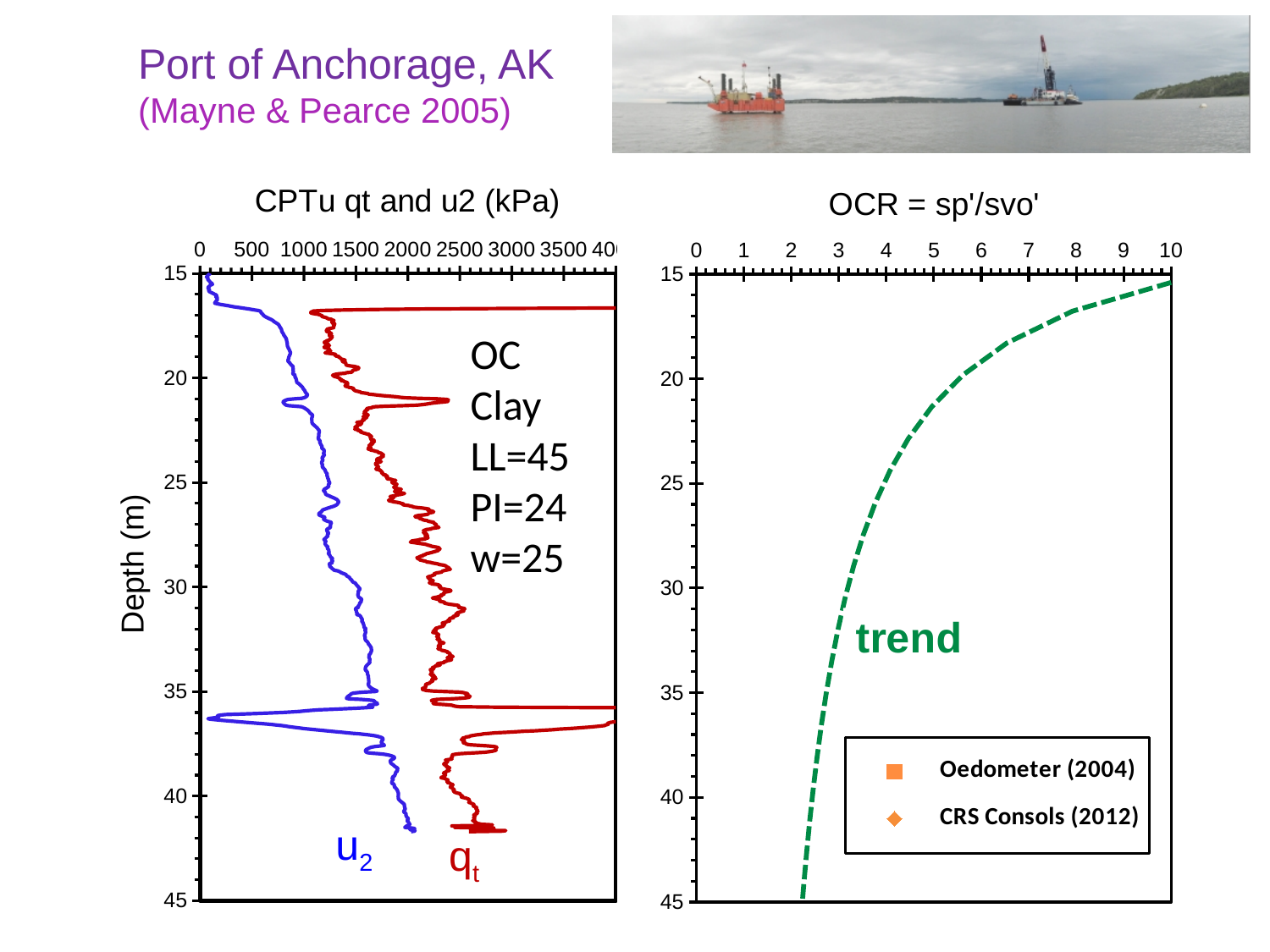
In the right chart "OCR = sp'/svo'", how many entries does the legend list? 2 In the left chart "CPTu qt and u2 (kPa)", at a depth of 30 m, which series has the larger value, qt or u2? qt In the left chart "CPTu qt and u2 (kPa)", what is the label of the vertical axis? Depth (m) In the left chart "CPTu qt and u2 (kPa)", does the u2 series generally increase or decrease as depth increases from 15 m to 40 m? increase What kind of chart is the right chart titled "OCR = sp'/svo'"? line chart In the right chart "OCR = sp'/svo'", at a depth of 40 m, is the trend line's OCR value greater or less than 3? less In the left chart "CPTu qt and u2 (kPa)", at a depth of 25 m, is the u2 value greater or less than 1500? less In the right chart "OCR = sp'/svo'", does the trend line's OCR value increase or decrease as depth increases? decrease In the left chart "CPTu qt and u2 (kPa)", how many data series are plotted? 2 In the right chart "OCR = sp'/svo'", at a depth of 20 m, is the trend line's OCR value greater or less than 4? greater In the left chart "CPTu qt and u2 (kPa)", which series is drawn in blue? u2 What kind of chart is the left chart titled "CPTu qt and u2 (kPa)"? line chart